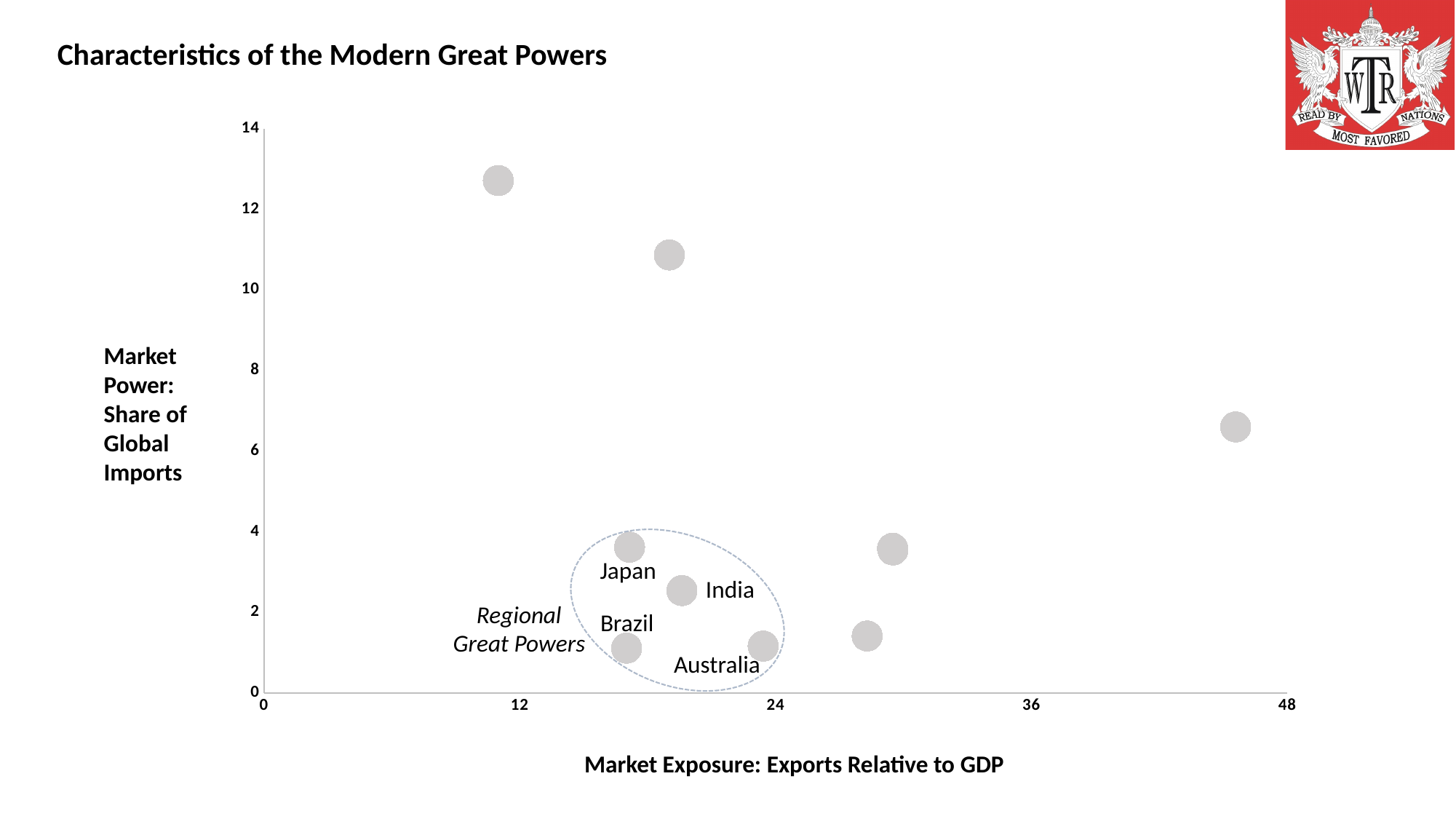
Which has the higher Market Exposure value, Australia or Brazil? Australia What label is given to the group of points enclosed by the dashed ellipse? Regional Great Powers Which has the higher share of global imports, Japan or Brazil? Japan Among the labelled countries, which has the highest Market Power value? Japan Is the Market Power value for India greater or less than 4? less How many data points are labelled with a country name? 4 What is the title of the x axis? Market Exposure: Exports Relative to GDP Is the Market Power value for Japan greater or less than 2? greater Is the Market Exposure value for Australia greater or less than 12? greater What kind of chart is shown on the slide? scatter chart